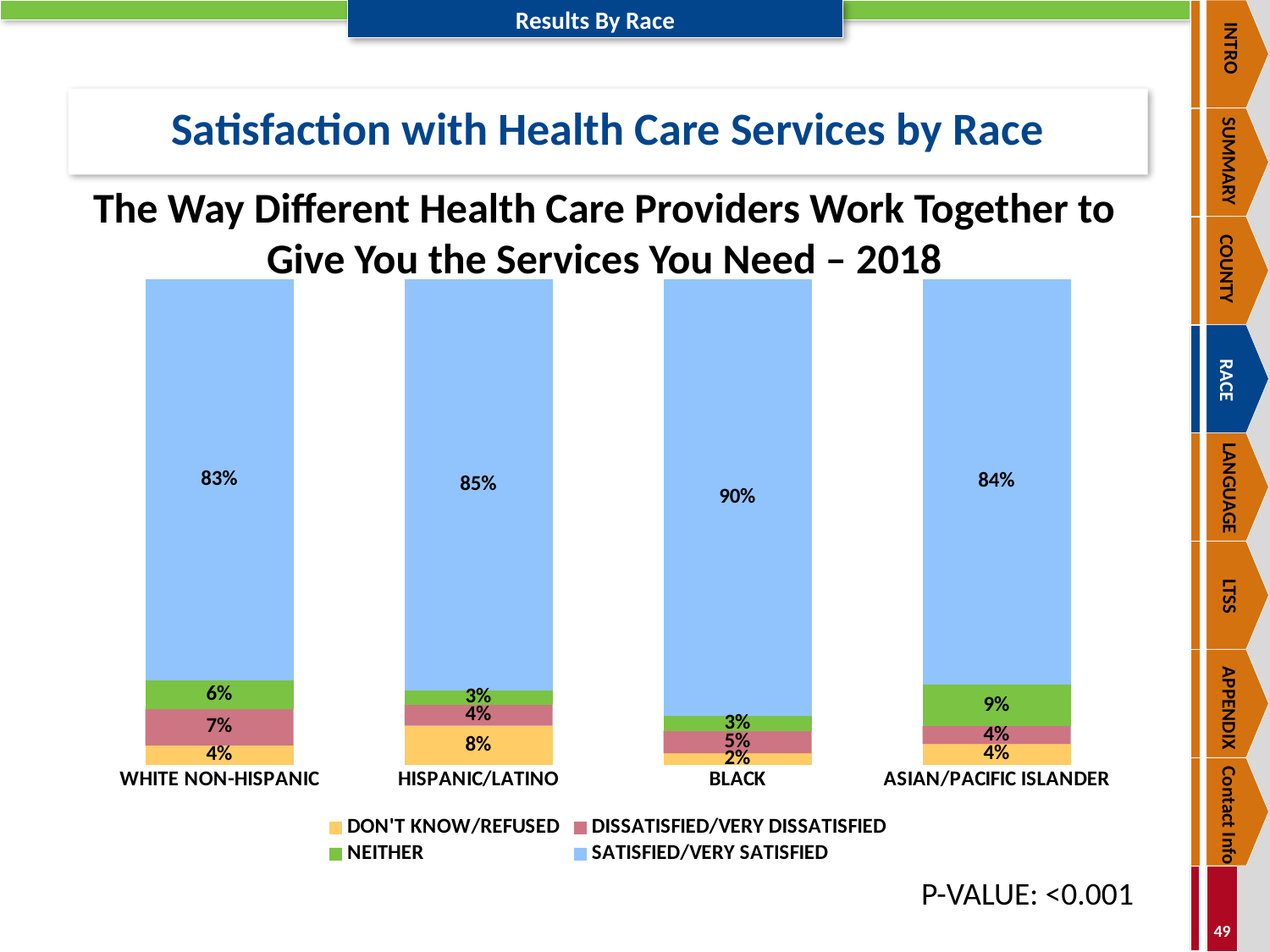
How many series does the legend list? 4 What percentage of Black respondents were Satisfied/Very Satisfied? 90% What is the Neither value for Asian/Pacific Islander? 9% What percentage of Hispanic/Latino respondents answered Don't Know/Refused? 8% Which is larger, the Neither value for White Non-Hispanic or for Hispanic/Latino? White Non-Hispanic Which race group has the highest Satisfied/Very Satisfied percentage? Black What is the difference between the Satisfied/Very Satisfied percentages for Black and White Non-Hispanic? 7% What is the total of the stacked bar for Hispanic/Latino? 100% Which race group has the lowest Don't Know/Refused percentage? Black What is the Dissatisfied/Very Dissatisfied value for White Non-Hispanic? 7% What kind of chart is shown on the slide? Stacked bar chart How many race categories are shown on the x axis? 4